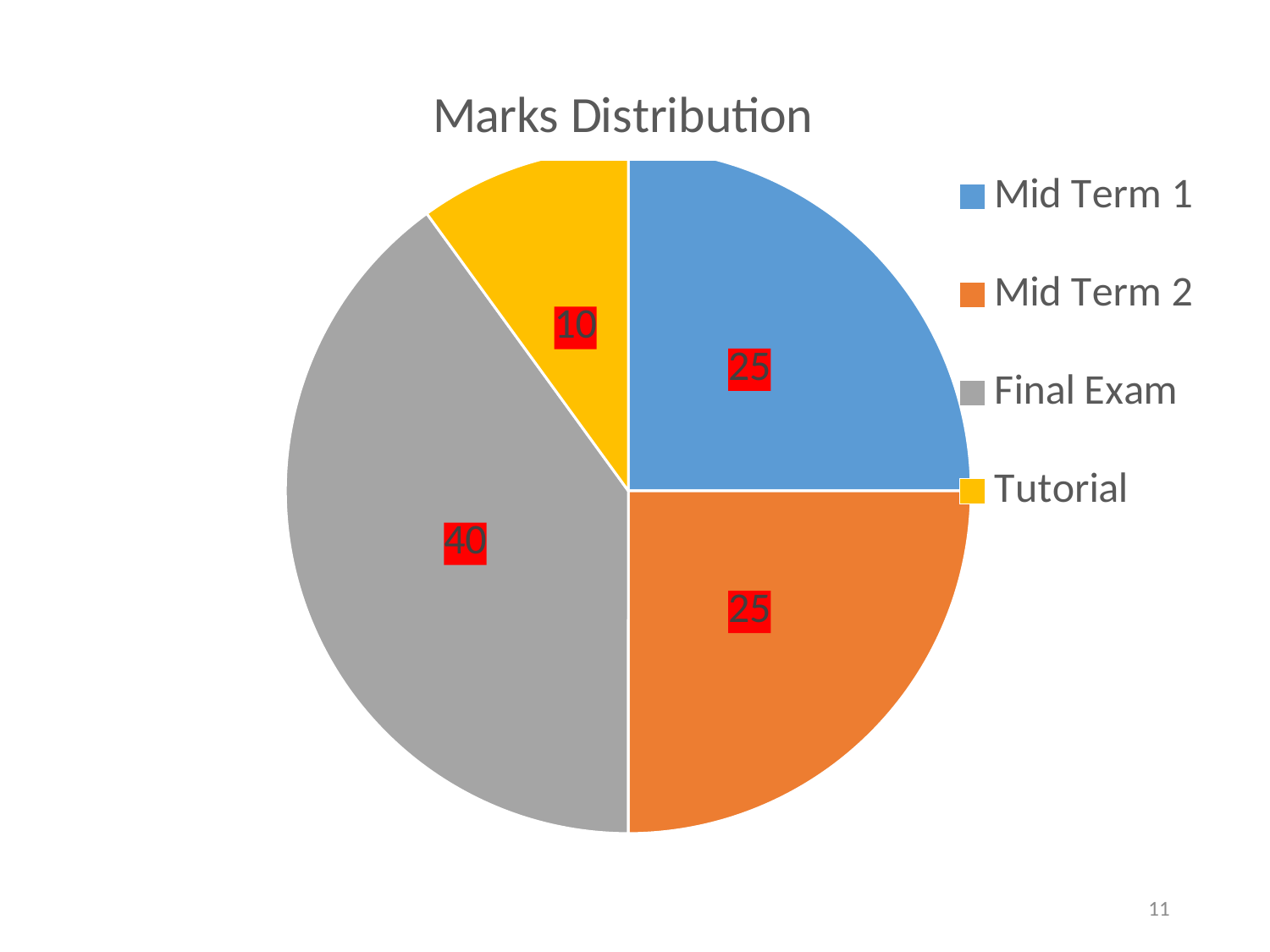
What is the value for Mid Term 1? 25 What is the difference between the Final Exam value and the Tutorial value? 30 How many categories does the pie chart have? 4 Which category has the smallest slice? Tutorial What is the value for Tutorial? 10 What kind of chart is shown? pie chart What is the value for Final Exam? 40 What is the total of all slices? 100 What is the title of the chart? Marks Distribution Which category has the largest slice? Final Exam Which is larger, Final Exam or Mid Term 2? Final Exam What share of the pie does Final Exam represent? 40%